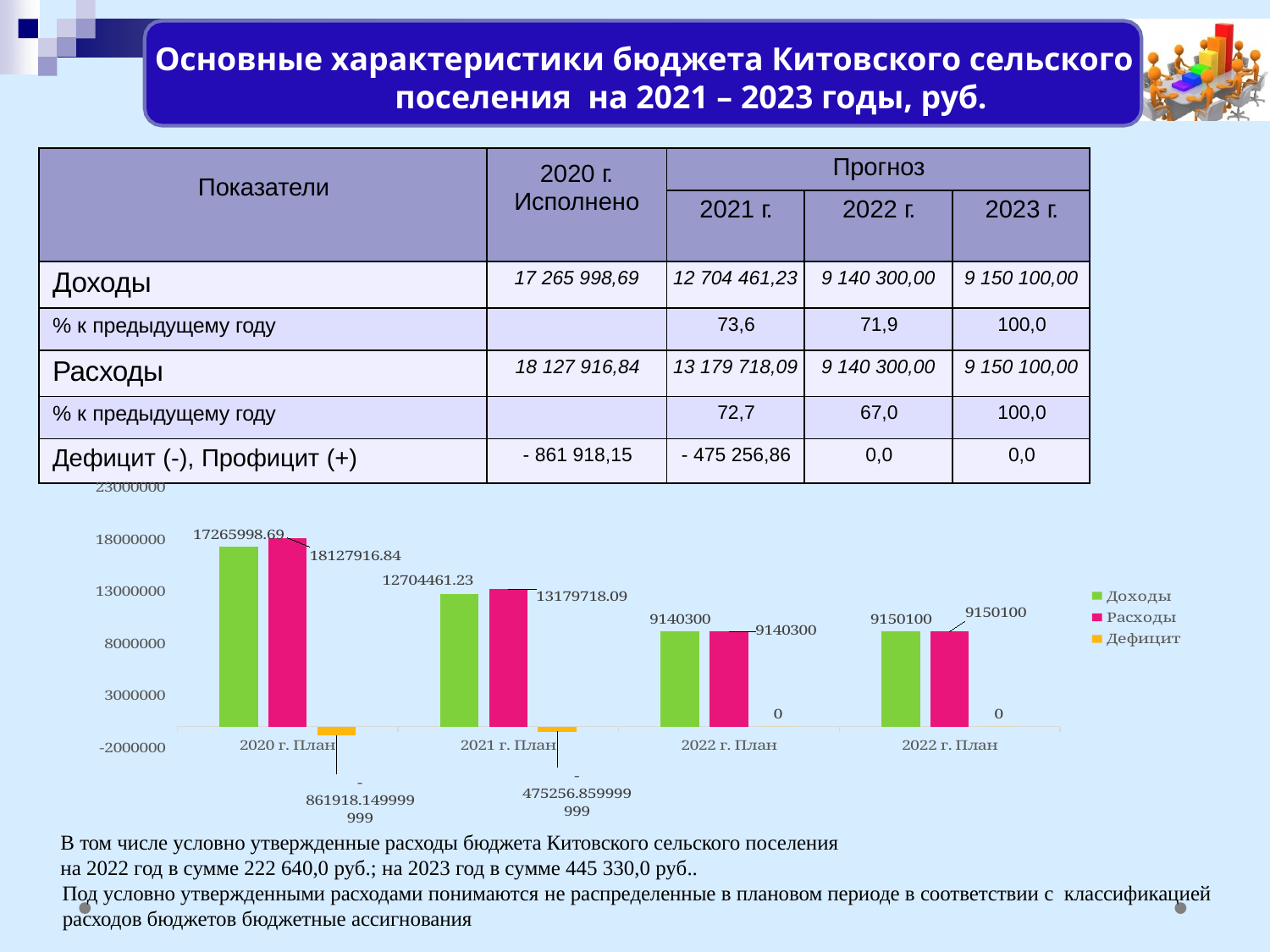
What is the value of Расходы for 2020 г. План in the chart? 18127916.84 What kind of chart is shown on the slide? bar chart How many series does the chart legend list? 3 What is the value of Расходы for 2021 г. План in the chart? 13179718.09 What is the value of Доходы for 2020 г. План in the chart? 17265998.69 What is the value of Доходы for 2021 г. План in the chart? 12704461.23 For 2020 г. План, which is larger in the chart, Доходы or Расходы? Расходы Which series in the chart legend is shown in green? Доходы Which category has the highest Доходы value in the chart? 2020 г. План What is the value of Дефицит for 2021 г. План in the chart? -475256.859999999 Do the Доходы values rise or fall from the first category to the last along the x axis of the chart? fall What is the difference between Расходы and Доходы for 2021 г. План in the chart? 475256.86